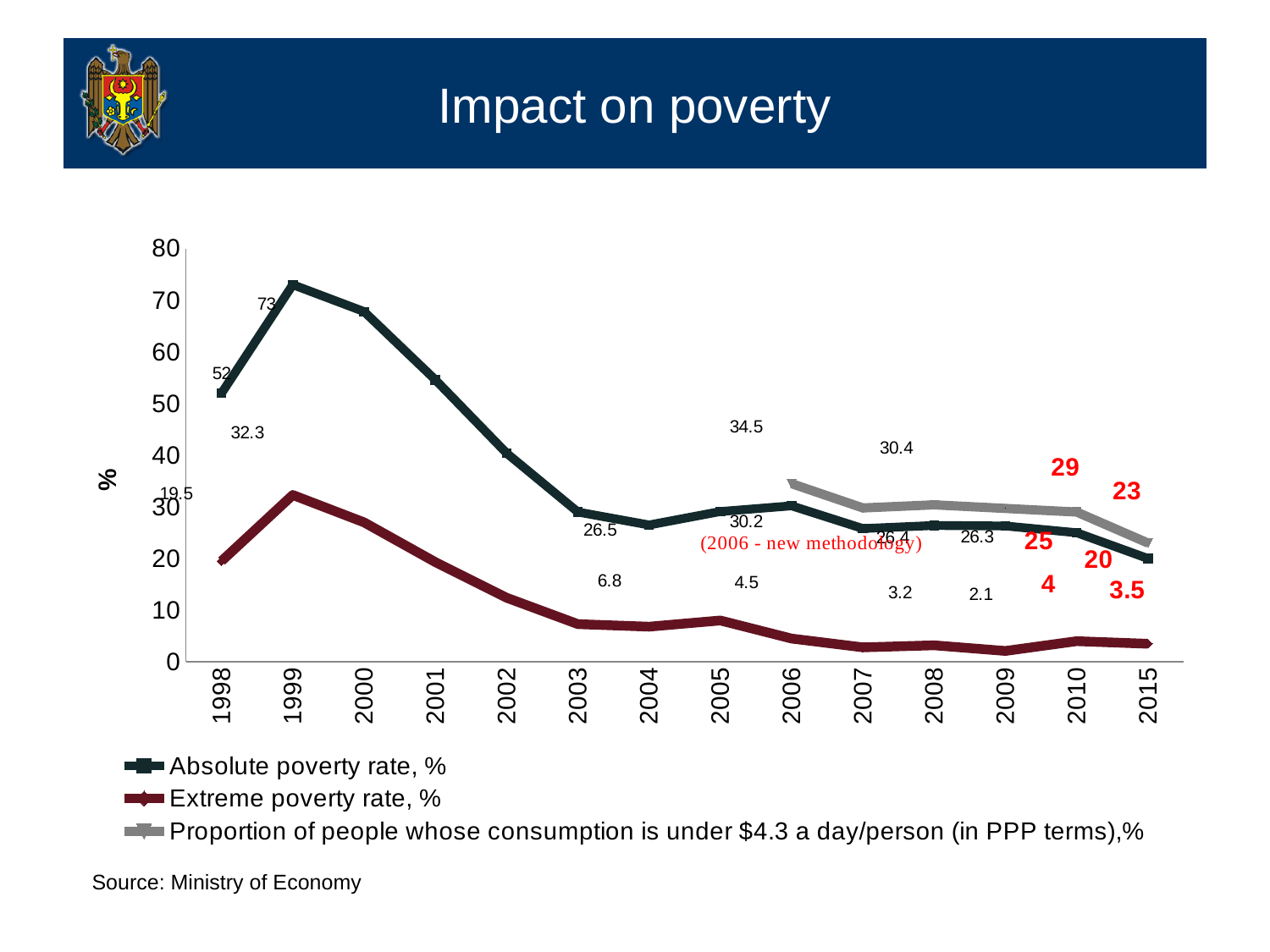
What kind of chart is shown on the slide? Line chart What is the difference between the absolute poverty rate in 1999 and in 1998? 21 Does the absolute poverty rate rise or fall between 1999 and 2003? Fall How many years are shown on the x axis? 14 What is the absolute poverty rate in 1998? 52 Is the absolute poverty rate in 2000 greater or less than 60? greater In which year does the absolute poverty rate reach its highest value? 1999 What is the value for the proportion of people whose consumption is under $4.3 a day/person in 2015? 23 Is the extreme poverty rate in 2002 greater or less than 20? less What is the highest value of the absolute poverty rate shown on the chart? 73 How many series does the legend list? 3 What is the extreme poverty rate in 2015? 3.5